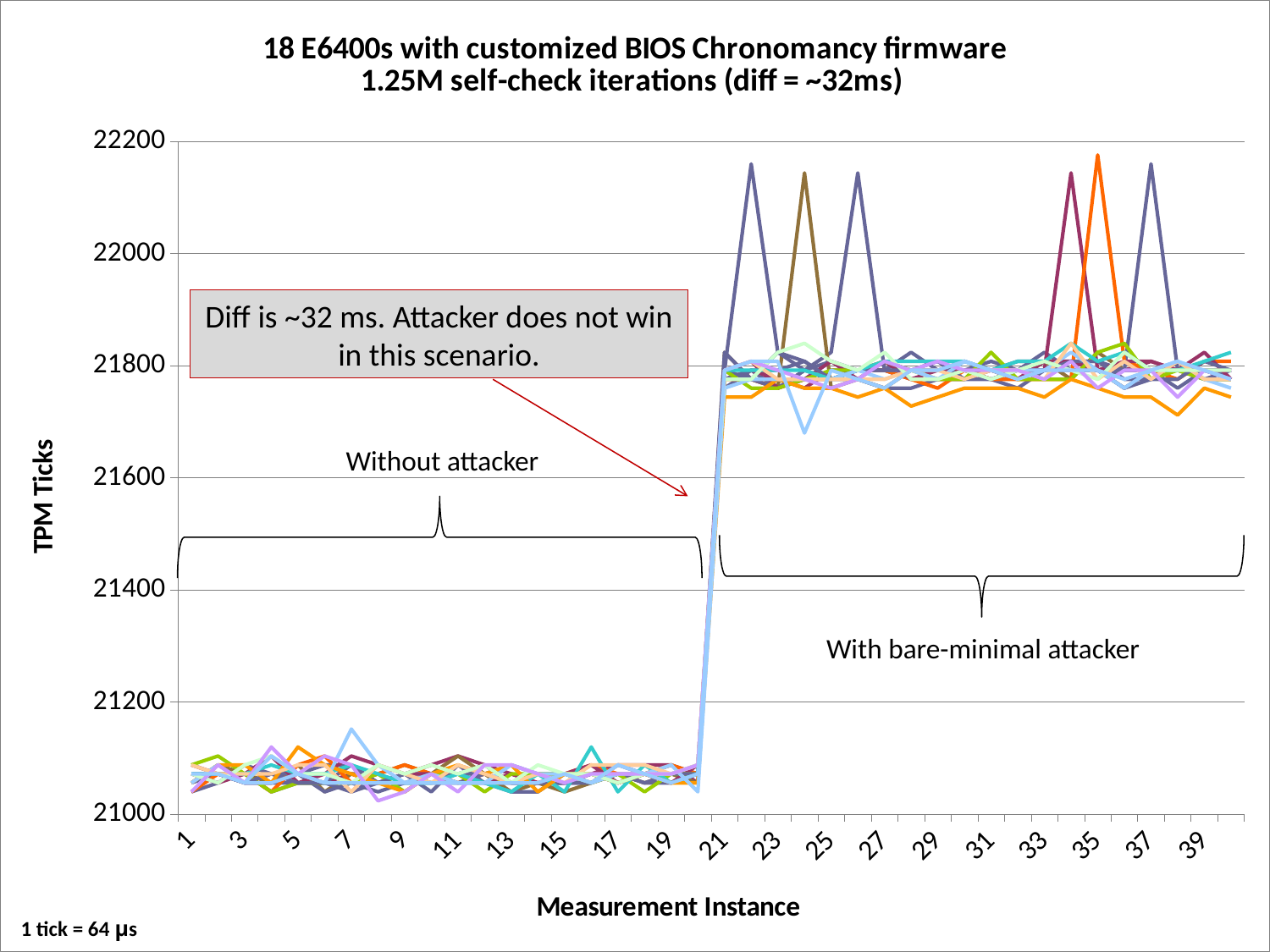
Are the values at measurement instance 30 greater or less than 21600 TPM ticks? greater What kind of chart is shown on the slide? line chart Are the values at measurement instance 10 greater or less than 21400 TPM ticks? less Do the values rise or fall between measurement instance 20 and measurement instance 21? rise Are the values at measurement instance 5 greater or less than 21200 TPM ticks? less What does the callout box on the chart say? Diff is ~32 ms. Attacker does not win in this scenario. What is the title of the chart? 18 E6400s with customized BIOS Chronomancy firmware 1.25M self-check iterations (diff = ~32ms) Are the values in the 'With bare-minimal attacker' region higher or lower than those in the 'Without attacker' region? higher